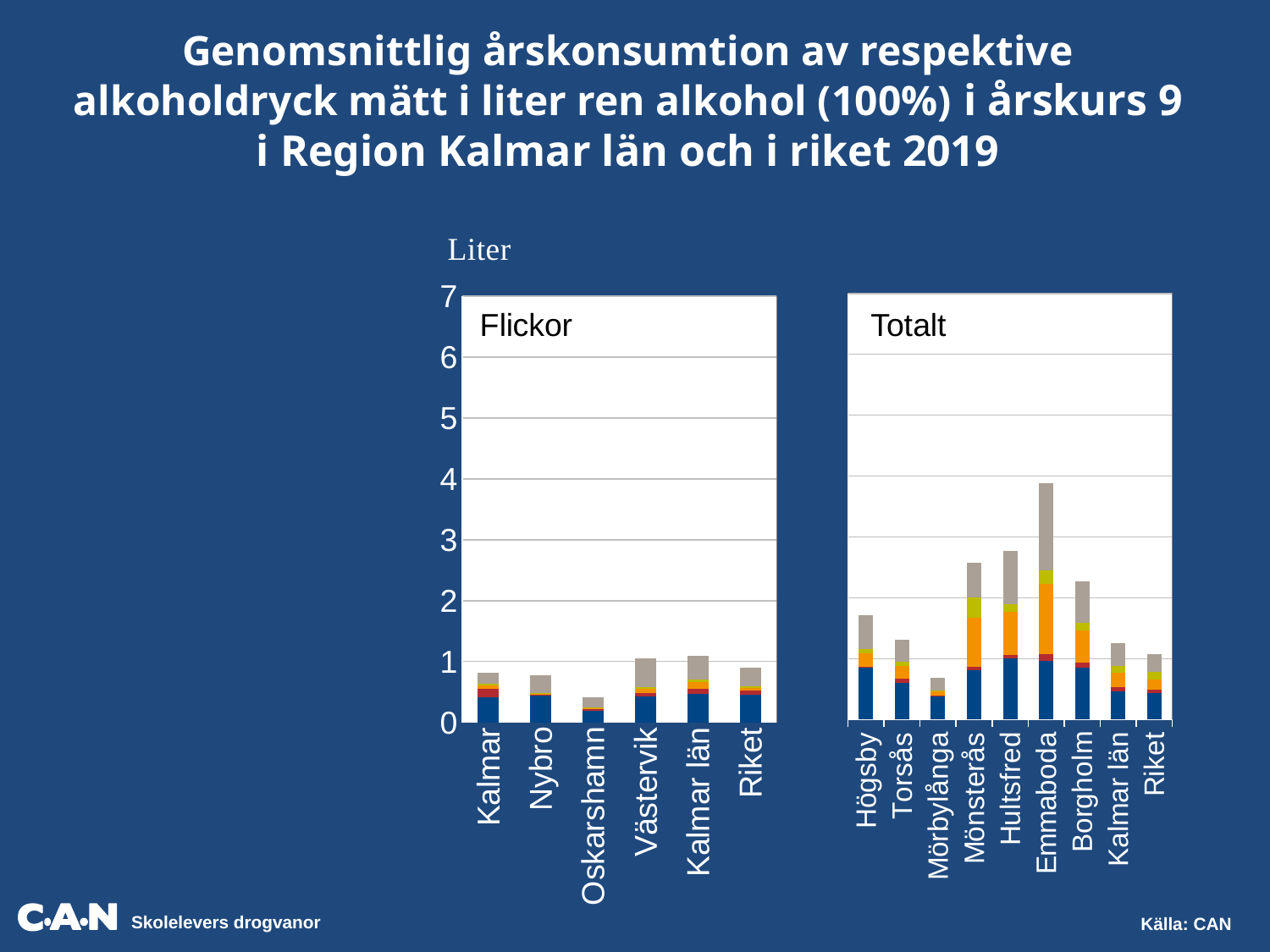
How many categories are shown on the x axis of the "Flickor" chart? 6 In the "Totalt" chart, which category has the highest total bar? Emmaboda In the "Totalt" chart, is the total value for Mörbylånga greater or less than 1? less In the "Totalt" chart, which category has the lowest total bar? Mörbylånga In the "Flickor" chart, is the total value for Oskarshamn greater or less than 1? less In the "Totalt" chart, is the total value for Emmaboda greater or less than 3? greater In the "Flickor" chart, which category has the lowest total bar? Oskarshamn What kind of chart is the "Totalt" chart on the right? Stacked bar chart How many categories are shown on the x axis of the "Totalt" chart? 9 What unit is shown as the label on the vertical axis of the charts? Liter In the "Totalt" chart, which has the larger total bar, Mönsterås or Torsås? Mönsterås In the "Totalt" chart, which has the larger total bar, Hultsfred or Högsby? Hultsfred